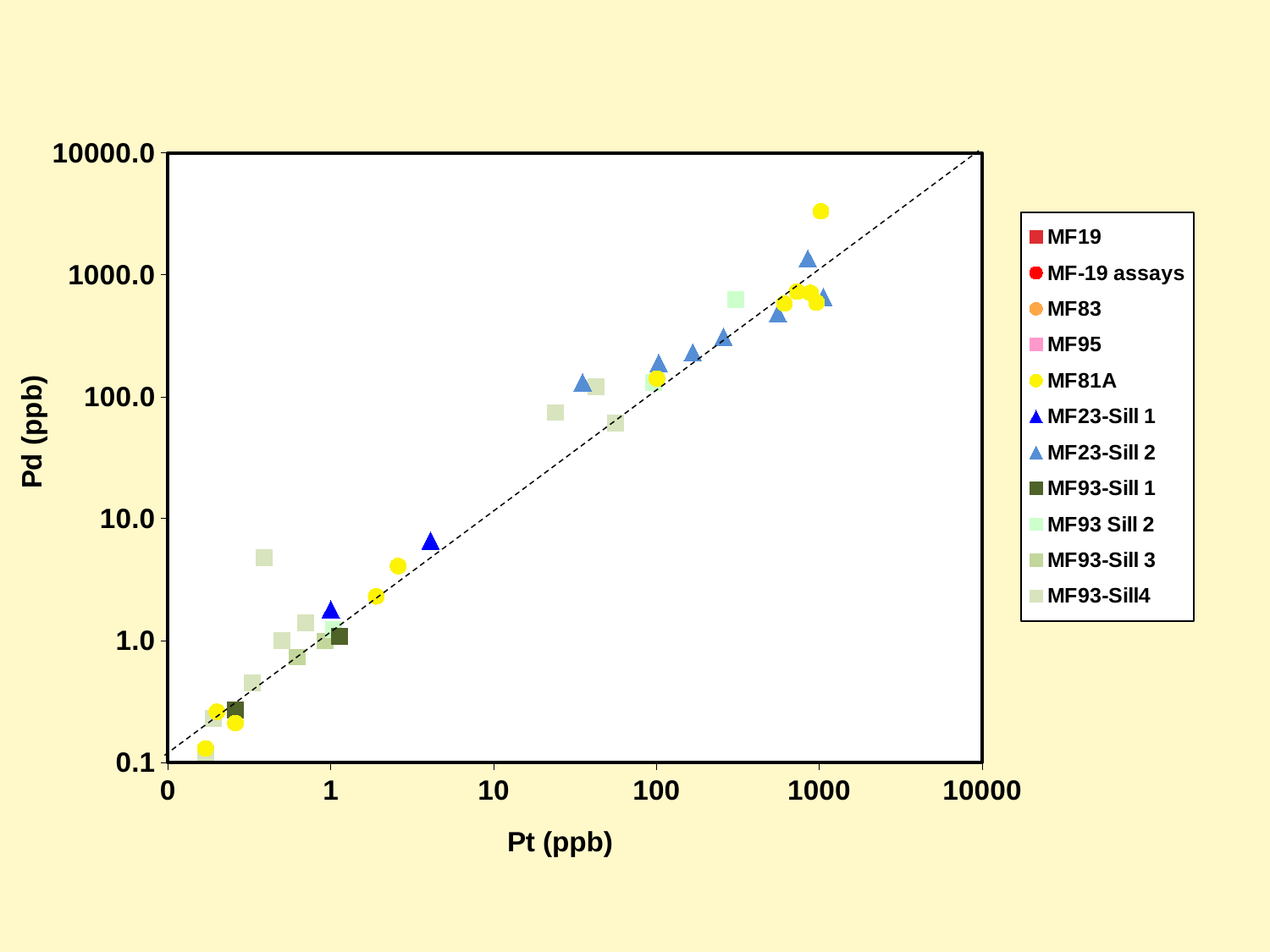
Is the Pd value of the MF93-Sill4 point at Pt of about 0.4 greater or less than 1.0? greater How many series does the legend list? 11 Is the Pd value of the MF23-Sill 1 point with the larger Pt value greater or less than 10? less Is the Pd value of the highest MF23-Sill 2 point greater or less than 1000? greater What is the label of the x axis? Pt (ppb) Which series has the point with the highest Pd value on the chart? MF81A What kind of chart is shown on the slide? Scatter chart Do the Pd values generally rise or fall as Pt increases along the x axis? Rise What is the label of the y axis? Pd (ppb) How many MF93-Sill 1 points are plotted on the chart? 2 How many MF23-Sill 1 points are plotted on the chart? 2